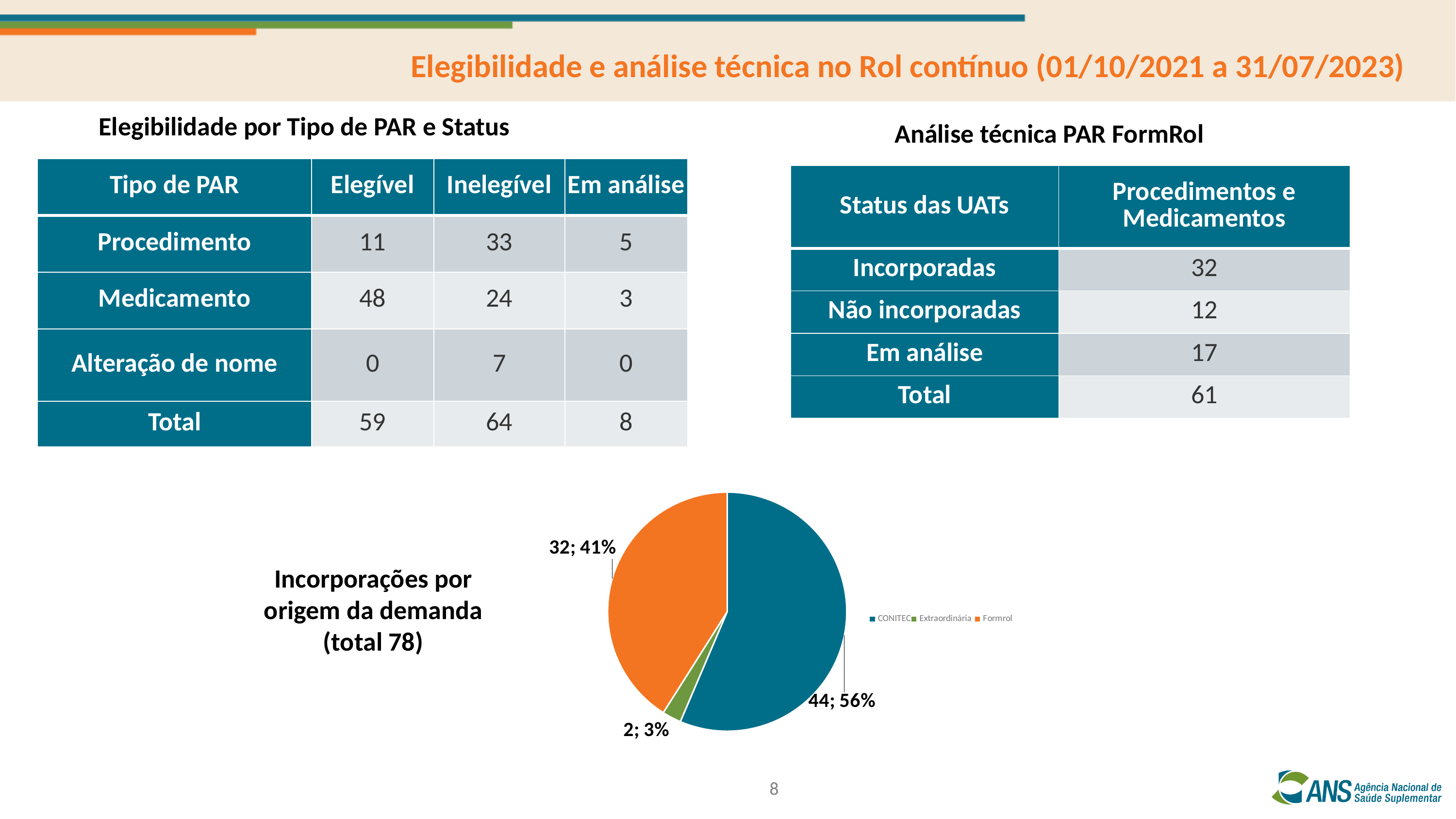
What share of the pie does Formrol represent? 41% How many slices does the pie chart have? 3 Which category has the smallest slice in the pie chart? Extraordinária What share of the pie does CONITEC represent? 56% What is the difference between the CONITEC and Formrol values in the pie chart? 12 What is the value for Extraordinária in the pie chart? 2 How many entries does the legend of the pie chart list? 3 What is the value for Formrol in the pie chart? 32 What kind of chart is shown on the slide? pie chart What is the value for CONITEC in the pie chart? 44 Which category has the largest slice in the pie chart? CONITEC Which colour represents Formrol in the pie chart? orange